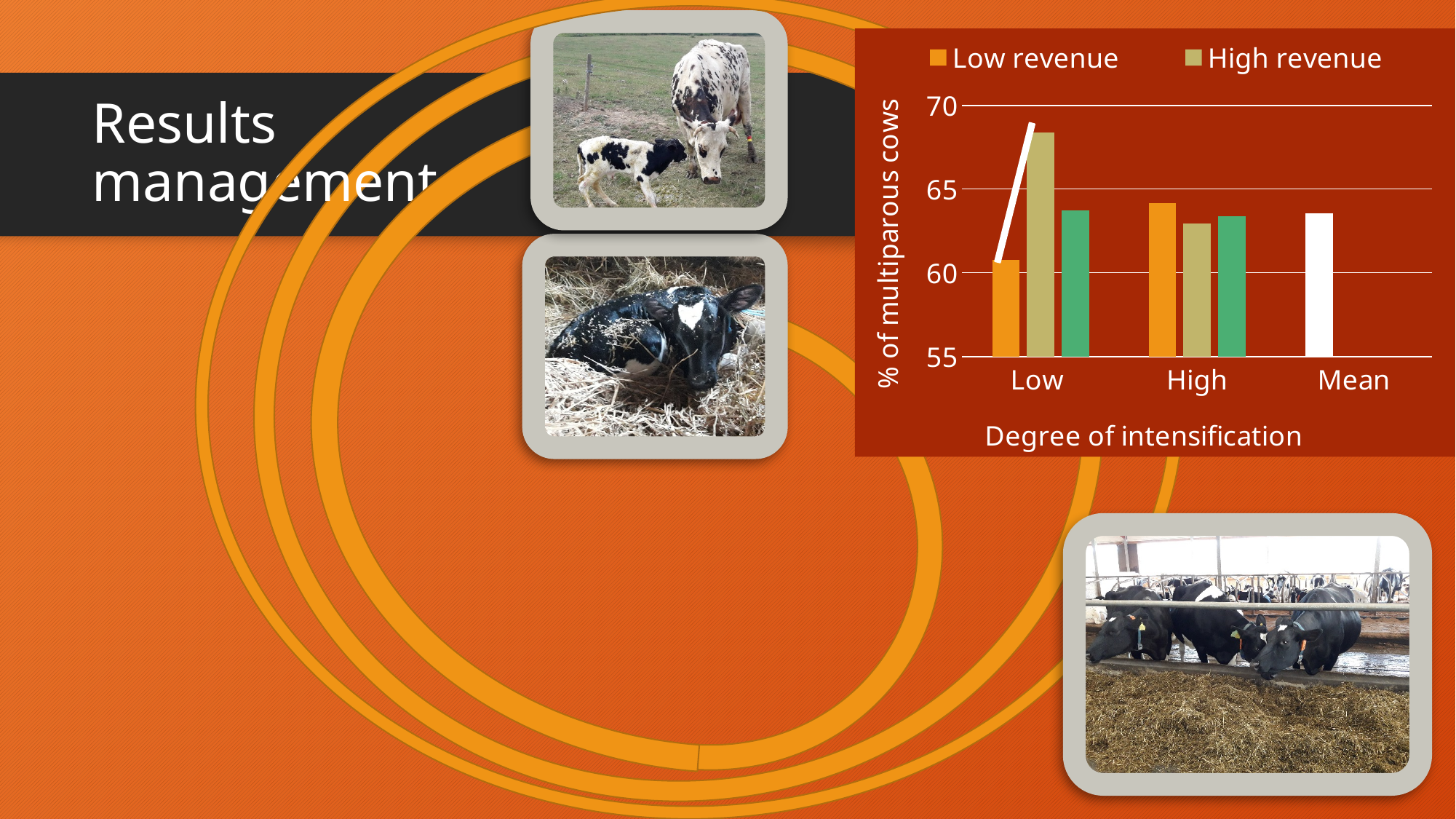
Which series and category has the highest bar in the chart? High revenue at Low How many series does the chart legend list? 2 For the Low degree of intensification, which is larger: the Low revenue value or the High revenue value? High revenue For the High degree of intensification, which is larger: the Low revenue value or the High revenue value? Low revenue What is the label of the y axis of the chart? % of multiparous cows Is the High revenue value for the Low degree of intensification greater or less than 65? greater How many categories are shown on the x axis of the chart? 3 Is the Low revenue value for the Low degree of intensification greater or less than 65? less What kind of chart is shown on the slide? bar chart Is the High revenue value for the High degree of intensification greater or less than 60? greater Does the Low revenue series rise or fall from the Low to the High degree of intensification? rise What is the label of the x axis of the chart? Degree of intensification